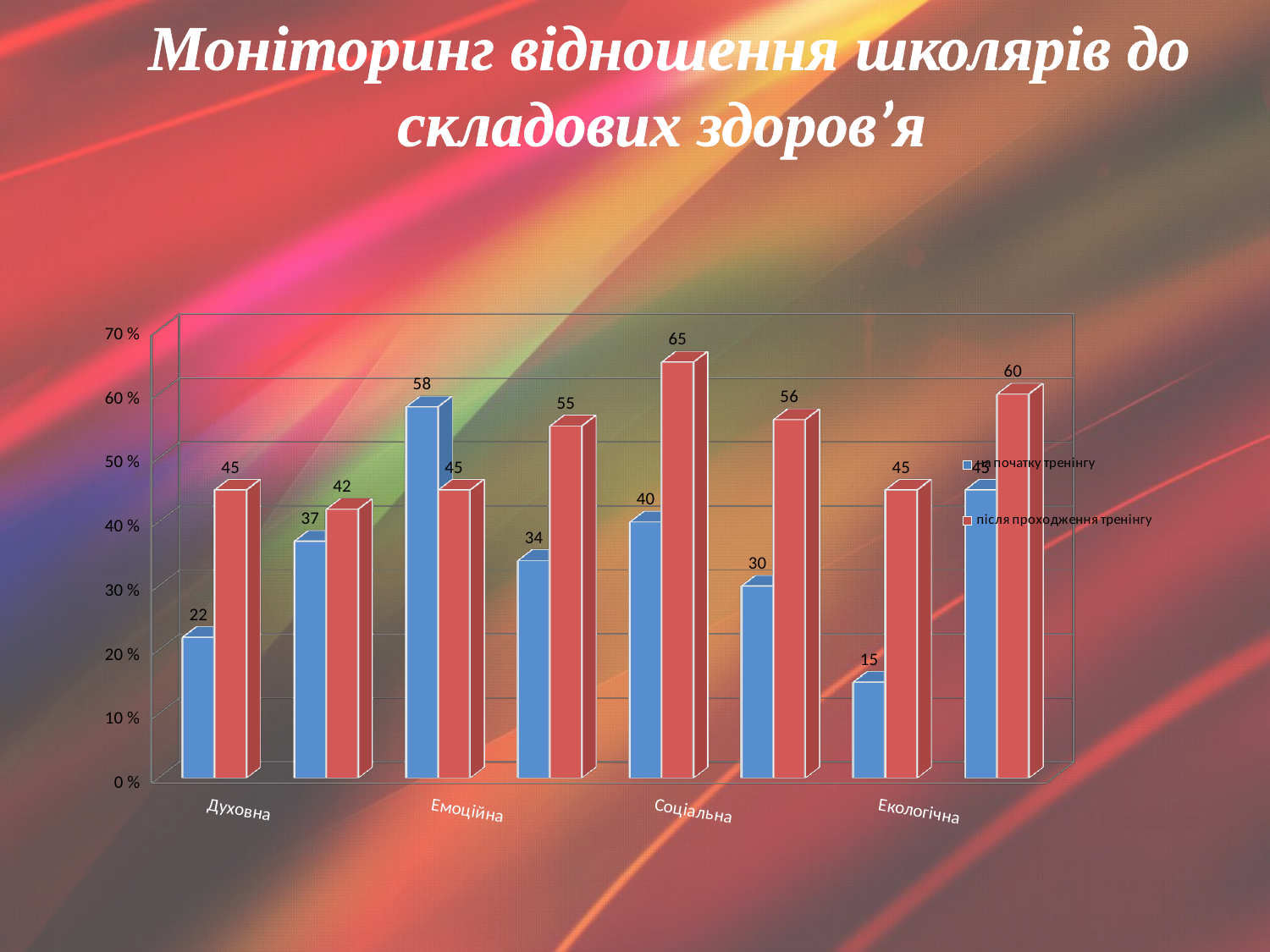
How many series does the legend list? 2 What is the value for Духовна in the series 'після проходження тренінгу'? 45 What kind of chart is shown on the slide? bar chart For Соціальна, what is the difference between the 'після проходження тренінгу' value and the 'на початку тренінгу' value? 25 Which labeled category has the lowest value in the series 'на початку тренінгу'? Екологічна What is the value for Соціальна in the series 'після проходження тренінгу'? 65 Which series is shown in red in the chart? після проходження тренінгу What is the value for Емоційна in the series 'на початку тренінгу'? 58 Which labeled category has the highest value in the series 'після проходження тренінгу'? Соціальна What is the value for Духовна in the series 'на початку тренінгу'? 22 What is the value for Екологічна in the series 'на початку тренінгу'? 15 For Емоційна, which series has the larger value: 'на початку тренінгу' or 'після проходження тренінгу'? на початку тренінгу